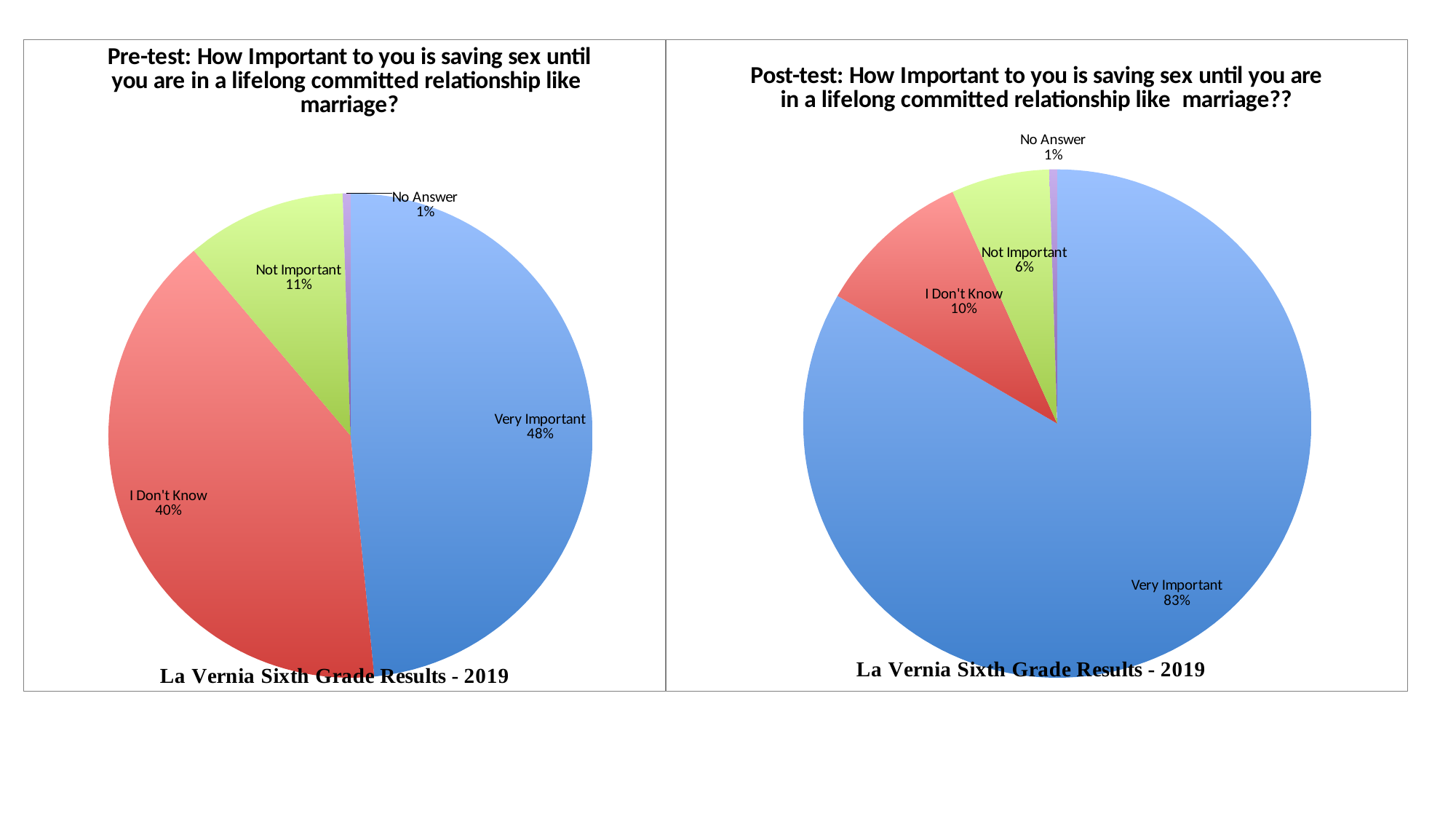
In the Pre-test pie chart, which category has the largest slice? Very Important In the Pre-test pie chart, what share of responses is 'I Don't Know'? 40% In the Post-test pie chart, what share of responses is 'Very Important'? 83% In the Pre-test pie chart, what is the difference between the 'Very Important' share and the 'I Don't Know' share? 8% What type of chart is the Pre-test chart? Pie chart In the Post-test pie chart, what share of responses is 'I Don't Know'? 10% Which is larger: the 'Not Important' share in the Pre-test chart or the 'Not Important' share in the Post-test chart? Pre-test How many categories are shown in the Post-test pie chart? 4 In the Post-test pie chart, which category has the smallest slice? No Answer What is the difference between the 'Very Important' share in the Post-test chart and the 'Very Important' share in the Pre-test chart? 35%